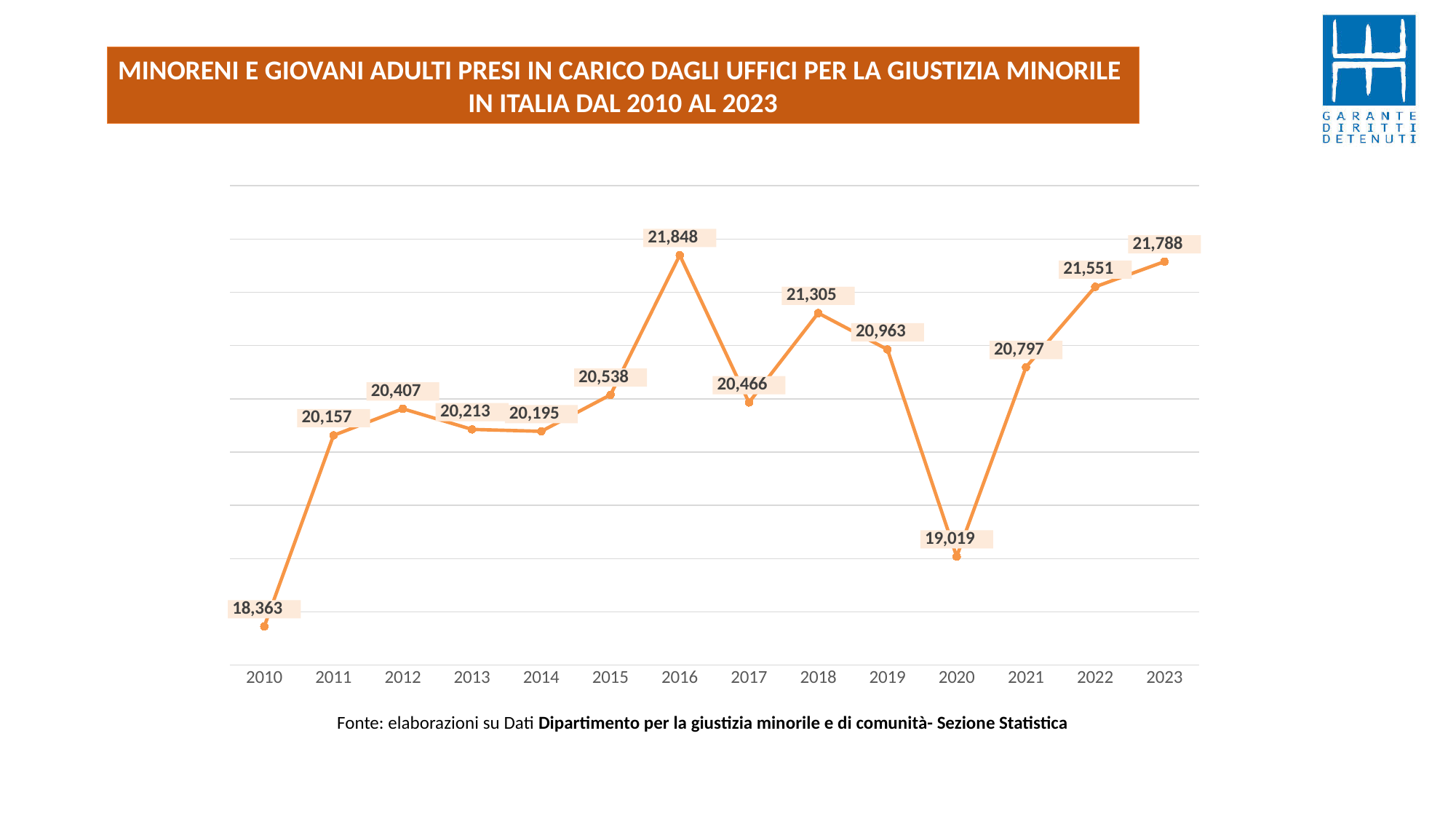
Which year has the highest value? 2016 How many years are plotted on the chart? 14 Which year has the lowest value? 2010 What is the value for 2016? 21,848 What is the value for 2020? 19,019 What is the value for 2023? 21,788 What is the difference between the values for 2016 and 2017? 1,382 Do the values rise or fall from 2020 to 2023? Rise What kind of chart is shown on the slide? Line chart What is the difference between the values for 2021 and 2020? 1,778 What is the value for 2010? 18,363 Which is larger, the value for 2012 or the value for 2013? 2012